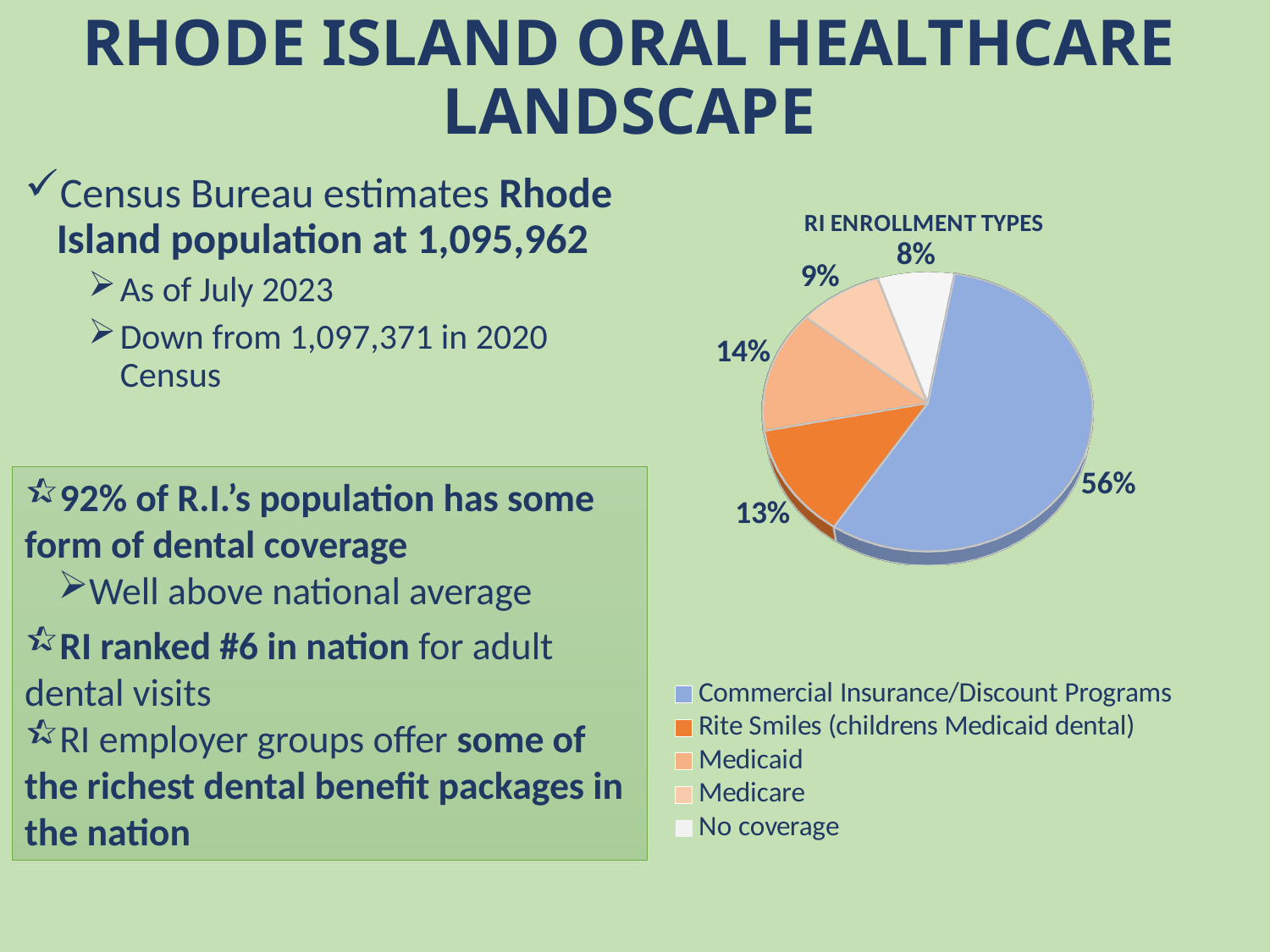
How many categories does the pie chart show? 5 What share of the pie is Medicaid? 14% What share of the pie is No coverage? 8% What share of the pie is Medicare? 9% Which is larger, the Medicaid share or the Rite Smiles (childrens Medicaid dental) share? Medicaid Which enrollment type has the smallest share of the pie? No coverage Which enrollment type has the largest share of the pie? Commercial Insurance/Discount Programs What type of chart is shown on the slide? Pie chart What is the difference in percentage points between the Commercial Insurance/Discount Programs share and the Medicaid share? 42 What is the title of the chart? RI ENROLLMENT TYPES